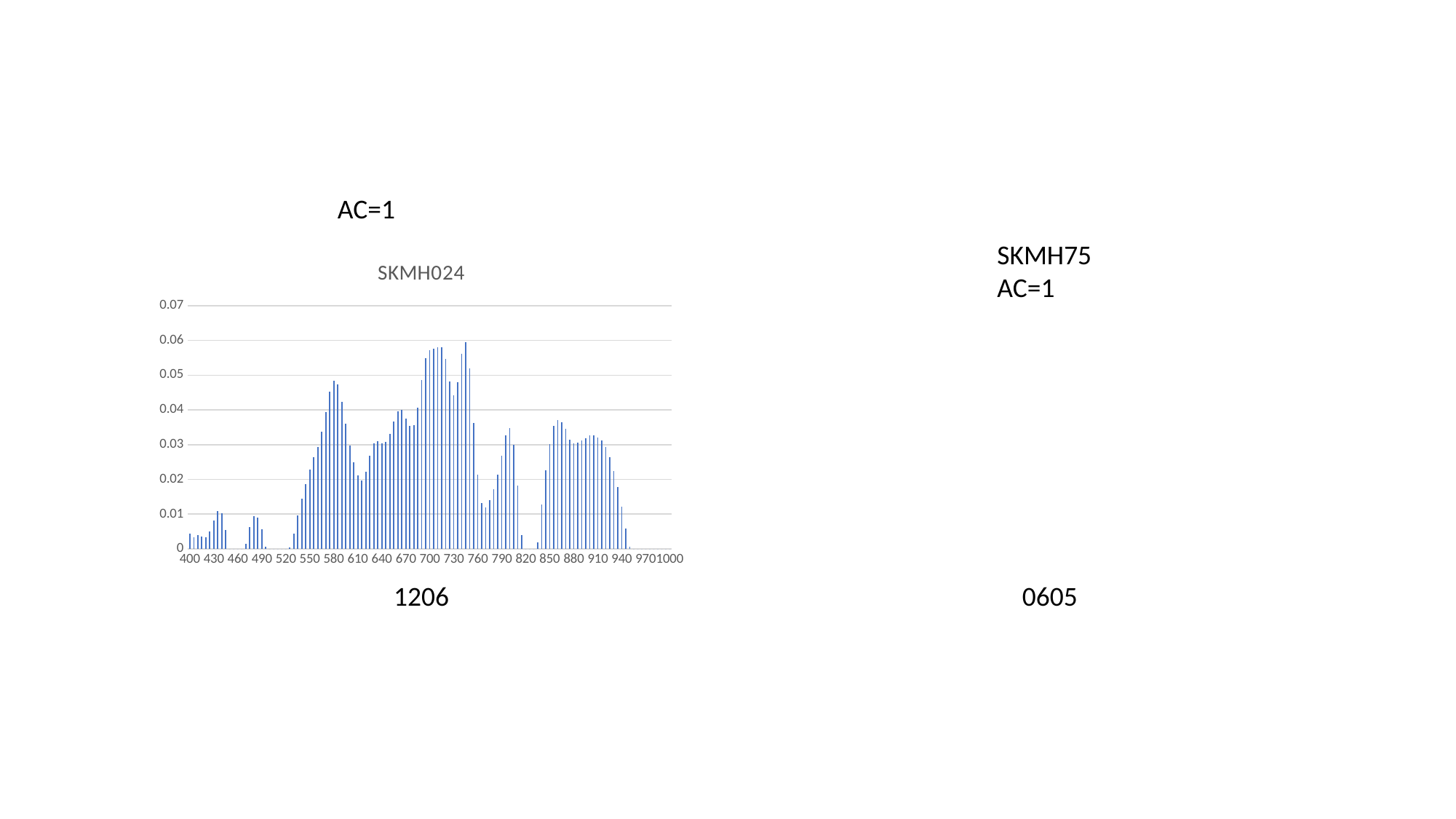
What is the title of the chart? SKMH024 Do any bars in the chart reach the 0.07 gridline? No What kind of chart is shown on the slide? bar chart Do the values generally rise or fall between 910 and 940 on the x axis? fall Is the value for 640 greater or less than 0.05? less Is the value for 580 greater or less than 0.04? greater What is the highest value labelled on the chart's vertical axis? 0.07 Do the values generally rise or fall between 520 and 580 on the x axis? rise